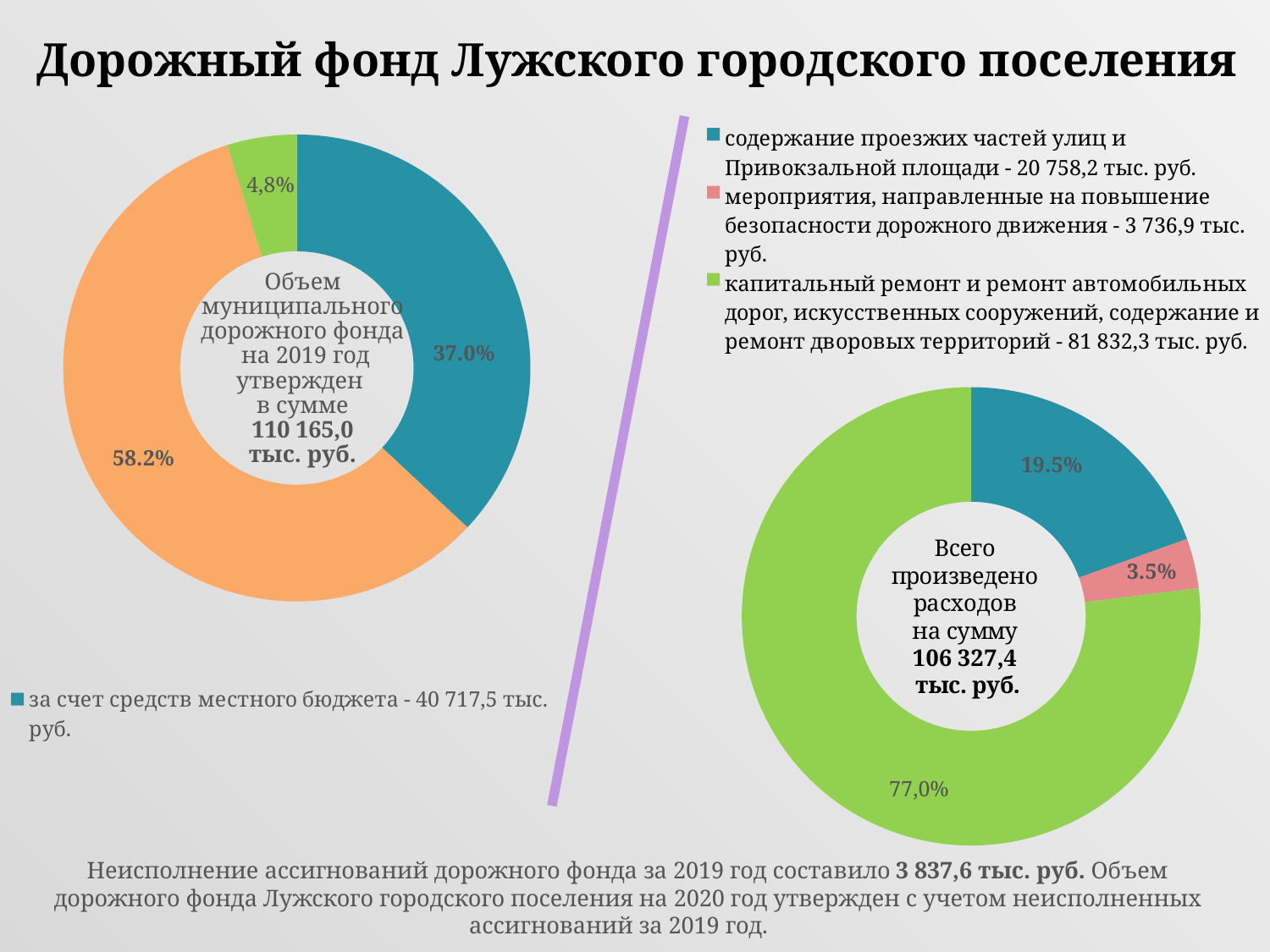
How many slices does the right chart have? 3 On the right chart, what share is shown for капитальный ремонт и ремонт автомобильных дорог, искусственных сооружений, содержание и ремонт дворовых территорий? 77,0% On the right chart, what share is shown for содержание проезжих частей улиц и Привокзальной площади? 19.5% What kind of chart is used on the left side of the slide? Doughnut (pie) chart On the right chart, which category has the largest share? капитальный ремонт и ремонт автомобильных дорог, искусственных сооружений, содержание и ремонт дворовых территорий On the right chart, what share is shown for мероприятия, направленные на повышение безопасности дорожного движения? 3.5% On the right chart, which is larger: the share for содержание проезжих частей улиц и Привокзальной площади or the share for мероприятия, направленные на повышение безопасности дорожного движения? содержание проезжих частей улиц и Привокзальной площади On the left chart, what share is shown for за счет средств местного бюджета? 37.0% On the right chart, which category has the smallest share? мероприятия, направленные на повышение безопасности дорожного движения What total amount is written in the centre of the right chart? 106 327,4 тыс. руб. How many entries does the legend of the right chart list? 3 On the right chart, what is the difference in percentage points between the share for содержание проезжих частей улиц и Привокзальной площади and the share for мероприятия, направленные на повышение безопасности дорожного движения? 16.0 percentage points